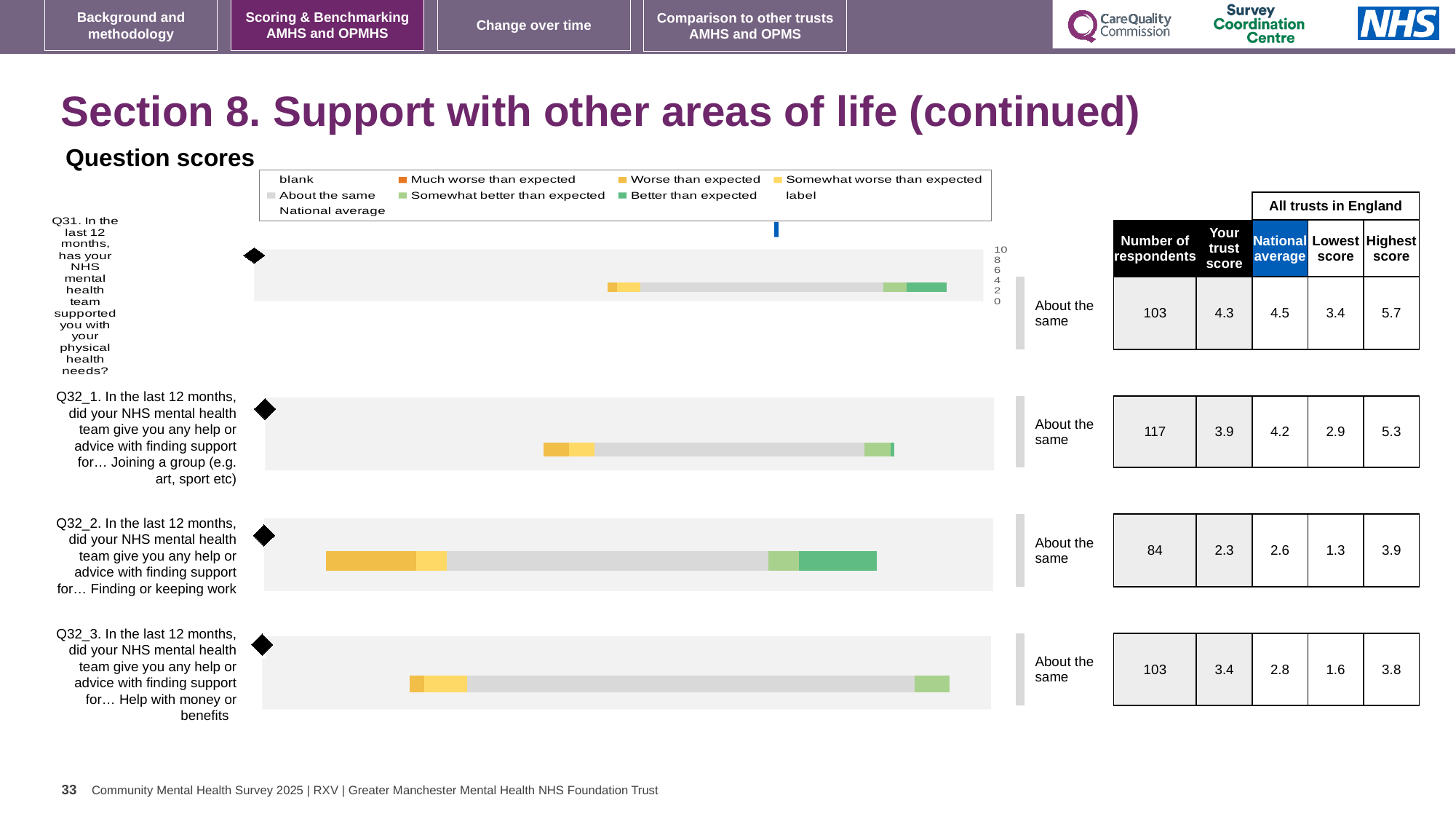
What kind of chart is used to show the question scores on this slide? bar chart Which of the four questions has the lowest 'Your trust score' in the table? Q32_2 (Finding or keeping work) In the legend, which colour represents 'Much worse than expected'? orange Is the trust score for Q32_3 (help with money or benefits) larger or smaller than its national average? larger In the legend, which colour represents 'About the same'? grey For the Q32_1 chart (joining a group), what is the national average shown in the table? 4.2 What is the difference between the highest score and the lowest score for Q31 in the table? 2.3 For the Q32_3 chart (help with money or benefits), what is the highest score among all trusts in England? 3.8 How many entries does the legend above the question score charts list? 9 For the Q32_2 chart (finding or keeping work), what is the number of respondents? 84 For the Q31 chart (physical health needs), what is the 'Your trust score' shown in the table? 4.3 How many question score bar charts are shown on the slide? 4